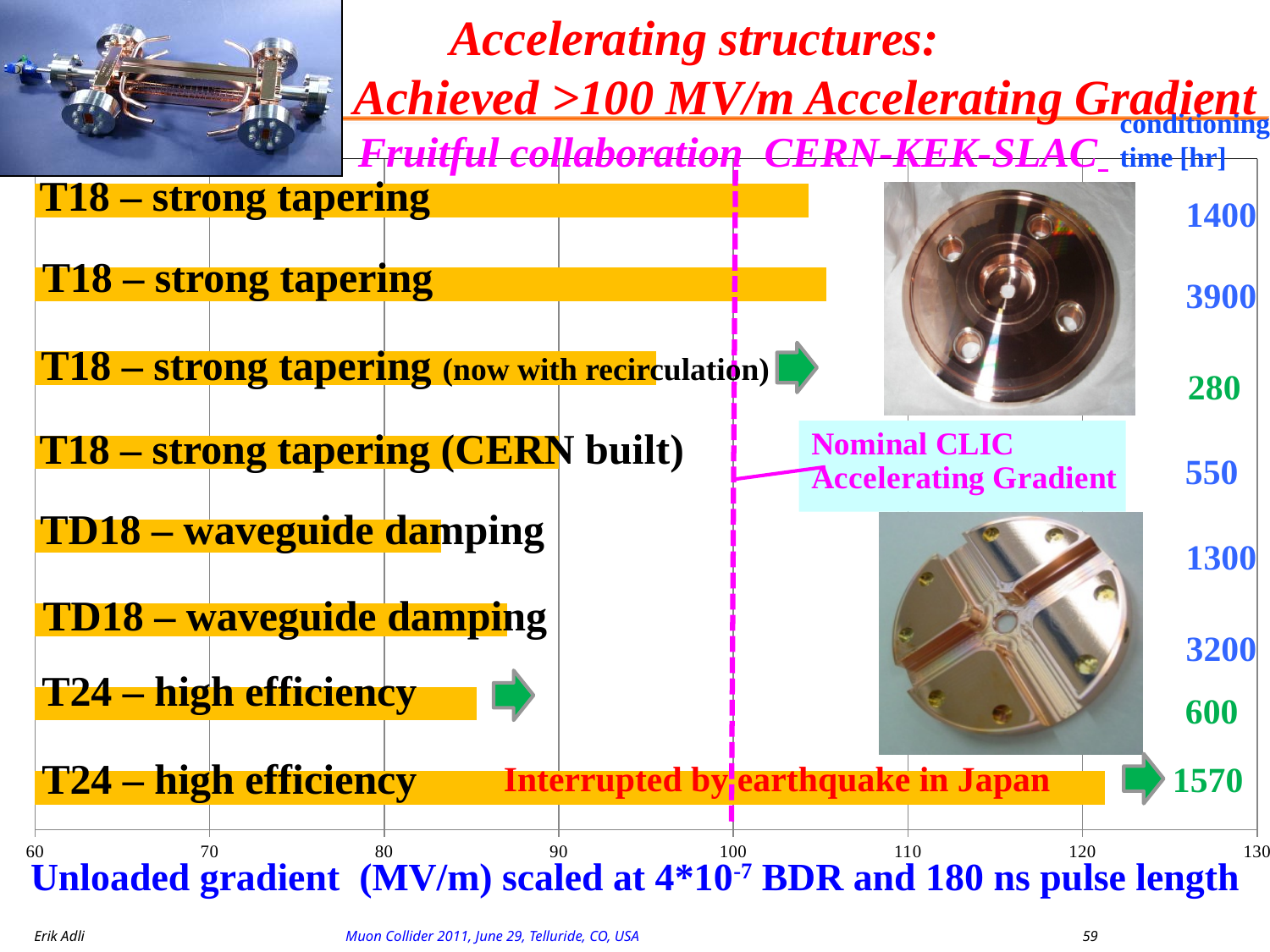
Is the value for the first 'TD18 – waveguide damping' bar greater or less than 90? less Is the value for the bar labelled 'T18 – strong tapering (CERN built)' greater or less than 100? less Is the value for the top bar (T18 – strong tapering) greater or less than 100? greater What conditioning time in hours is listed for the bottom 'T24 – high efficiency' bar? 1570 Which is larger: the second 'T18 – strong tapering' bar or the 'T18 – strong tapering (now with recirculation)' bar? the second T18 – strong tapering bar Which bar is the longest in the chart? T24 – high efficiency (bottom bar) Which is larger: the bottom 'T24 – high efficiency' bar or the top 'T18 – strong tapering' bar? T24 – high efficiency (bottom bar) How many bars are plotted in the chart? 8 What kind of chart is shown on the slide? bar chart What does the dashed vertical line at 100 MV/m represent? Nominal CLIC Accelerating Gradient